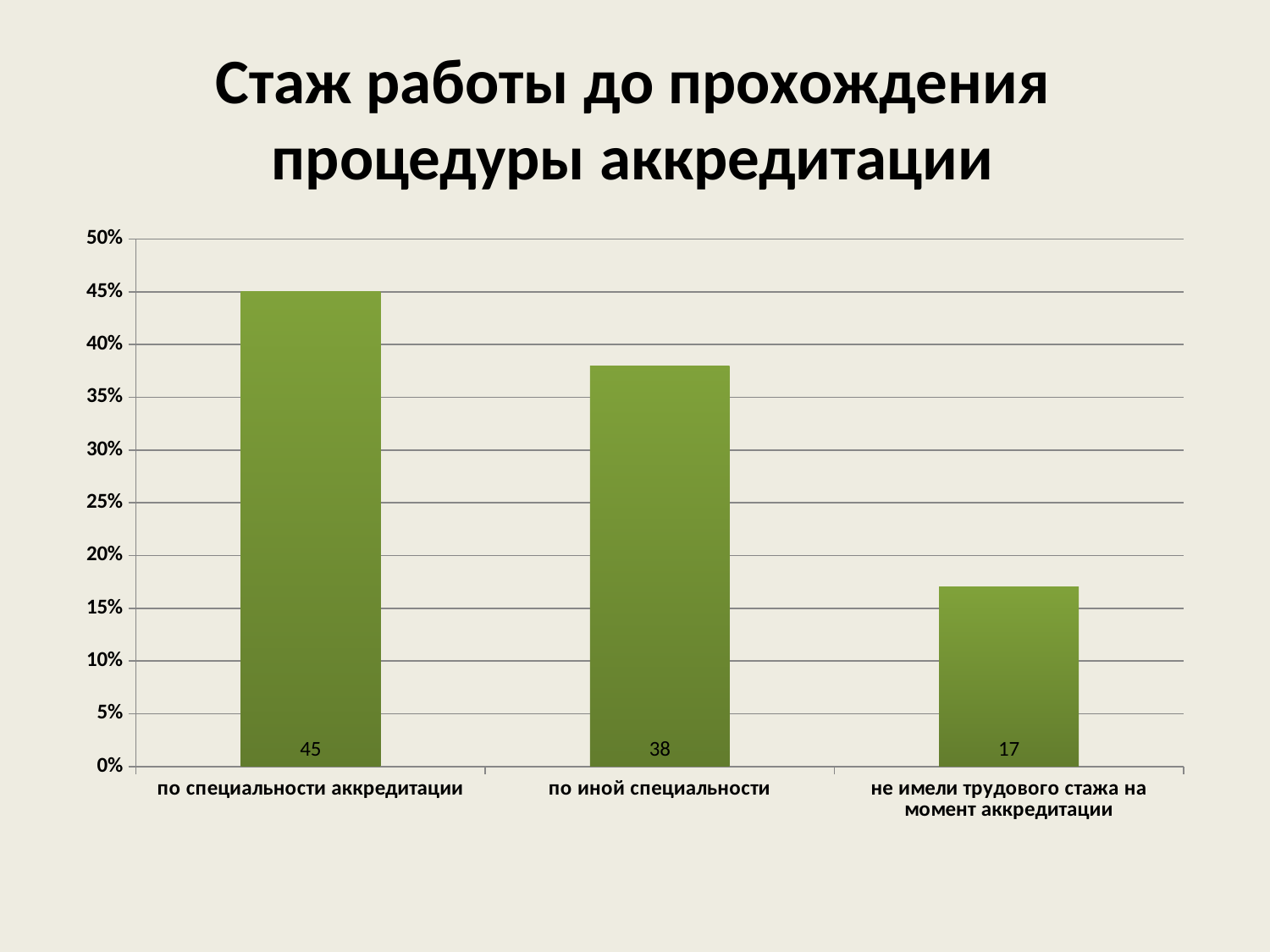
What is the value for "не имели трудового стажа на момент аккредитации"? 17 Which category has the highest value? по специальности аккредитации How many categories are shown on the chart? 3 What is the value for "по иной специальности"? 38 What kind of chart is shown on the slide? bar chart Is the value for "по иной специальности" greater or less than 40%? less What is the difference between the values for "по специальности аккредитации" and "по иной специальности"? 7 What is the difference between the values for "по иной специальности" and "не имели трудового стажа на момент аккредитации"? 21 What is the value for "по специальности аккредитации"? 45 What is the title of the chart? Стаж работы до прохождения процедуры аккредитации Which category has the lowest value? не имели трудового стажа на момент аккредитации Which is larger: the value for "по иной специальности" or for "не имели трудового стажа на момент аккредитации"? по иной специальности